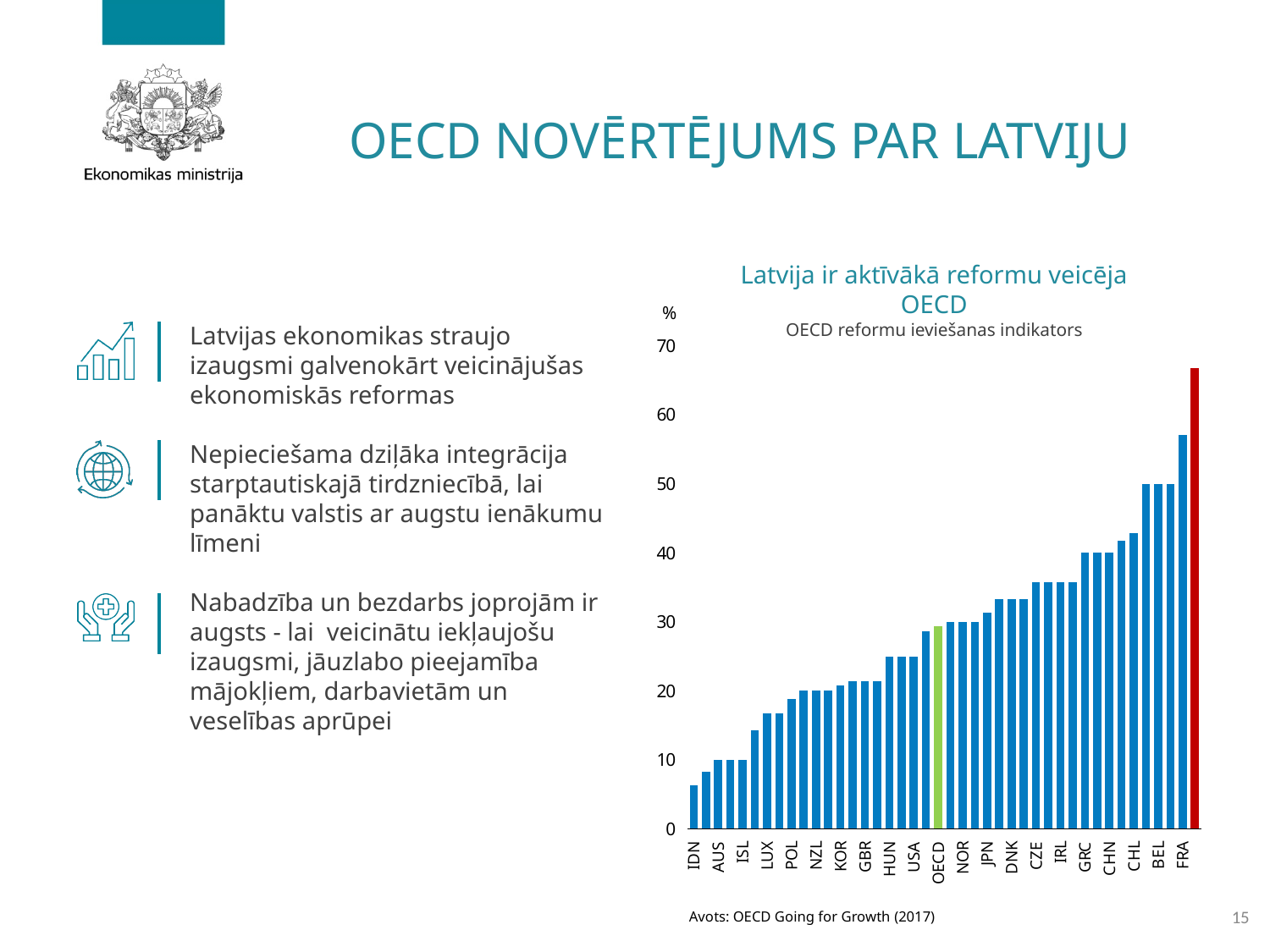
Which has a larger value, HUN or POL? HUN Is the value for IDN greater or less than 10? less What is the subtitle printed under the chart title? OECD reformu ieviešanas indikators Is the value for CHL greater or less than 40? greater Is the value of the tallest (red) bar greater or less than 60? greater Do the bar values rise or fall from left to right along the x axis? rise Which country has the lowest value in the chart? IDN What kind of chart is shown on the slide? bar chart What is the title of the chart? Latvija ir aktīvākā reformu veicēja OECD Which has a larger value, NOR or LUX? NOR